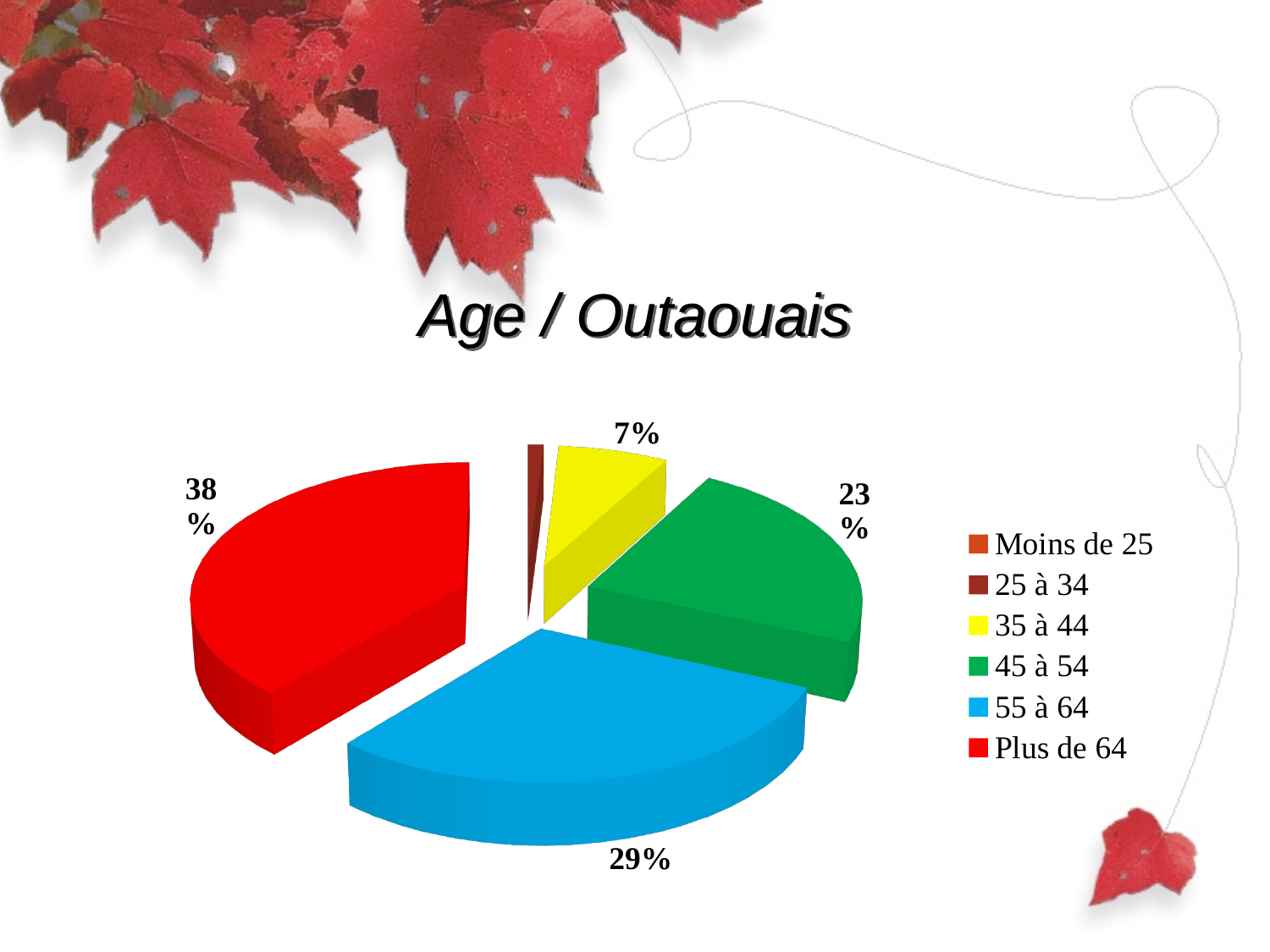
What percentage is shown for the 45 à 54 age group? 23% What percentage is shown for the Plus de 64 age group? 38% Which is larger, the share for 45 à 54 or the share for 55 à 64? 55 à 64 What percentage is shown for the 35 à 44 age group? 7% What is the difference in percentage points between the 45 à 54 share and the 35 à 44 share? 16 What is the difference in percentage points between the Plus de 64 share and the 55 à 64 share? 9 How many age groups does the legend list? 6 What is the title of the chart? Age / Outaouais What kind of chart is shown on the slide? pie chart Which age group has the largest share of the pie? Plus de 64 What colour is the Plus de 64 slice? red What percentage is shown for the 55 à 64 age group? 29%